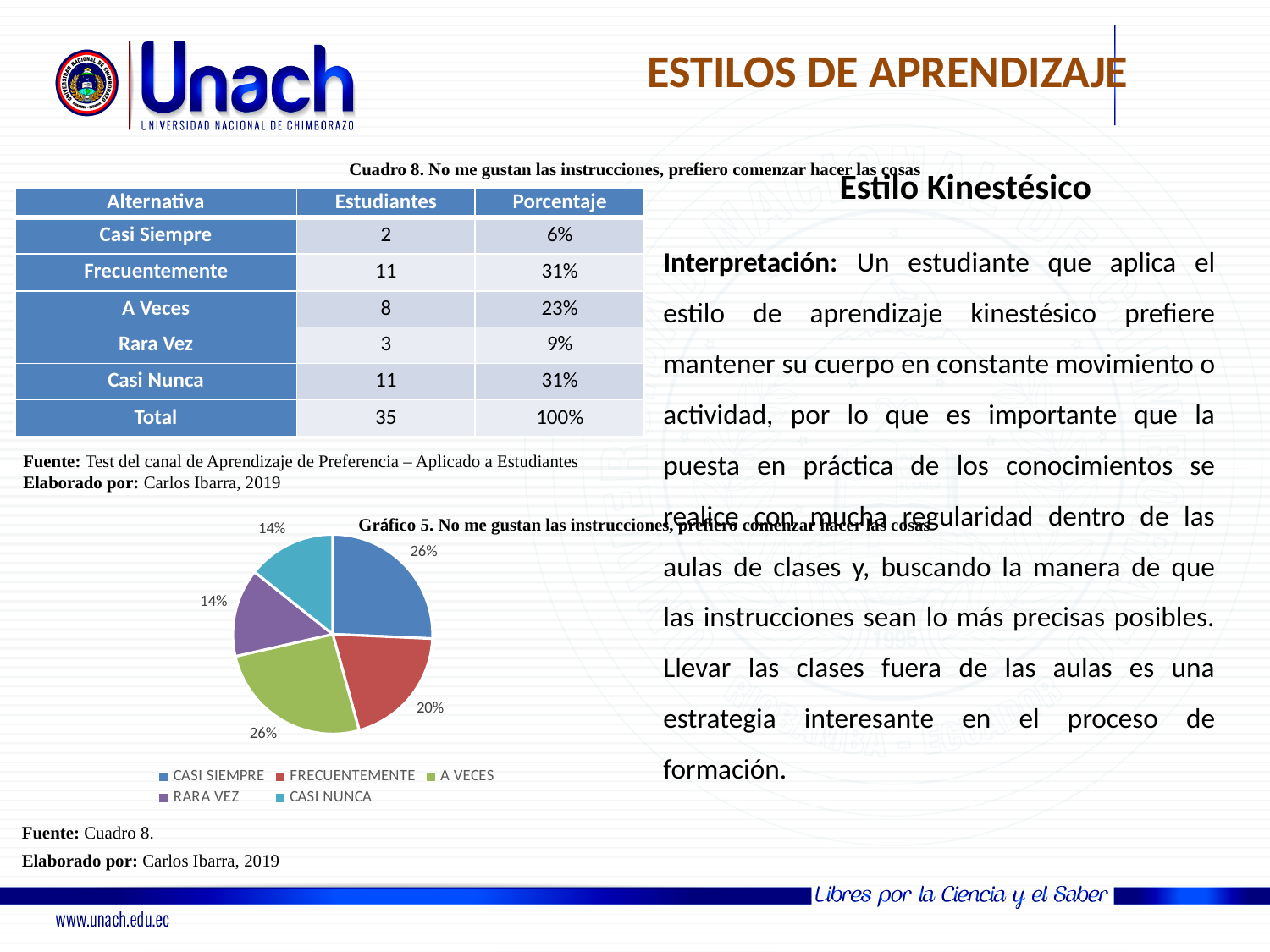
How many entries does the pie chart legend list? 5 What is the difference in percentage points between the CASI SIEMPRE slice and the FRECUENTEMENTE slice? 6 What percentage does the FRECUENTEMENTE slice show in the pie chart? 20% How many slices does the pie chart have? 5 Which slice is larger in the pie chart, FRECUENTEMENTE or RARA VEZ? FRECUENTEMENTE What percentage does the CASI NUNCA slice show in the pie chart? 14% What is the title of the pie chart? Gráfico 5. No me gustan las instrucciones, prefiero comenzar hacer las cosas What type of chart is shown on the slide? pie chart What percentage does the A VECES slice show in the pie chart? 26% Which slice is larger in the pie chart, CASI SIEMPRE or FRECUENTEMENTE? CASI SIEMPRE What percentage does the CASI SIEMPRE slice show in the pie chart? 26% What percentage does the RARA VEZ slice show in the pie chart? 14%